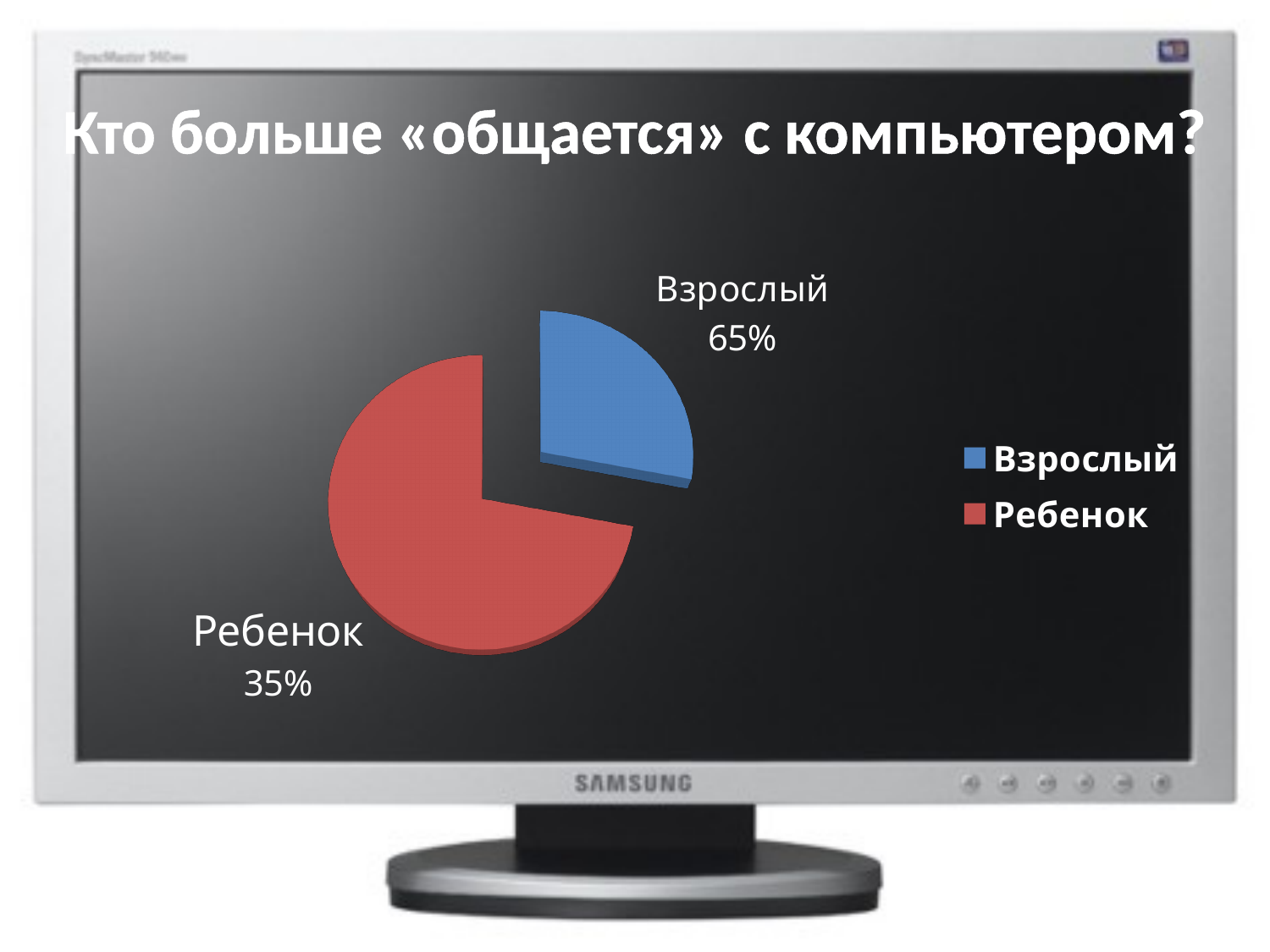
What percentage is shown for Ребенок in the pie chart? 35% How many entries does the legend list? 2 What percentage is shown for Взрослый in the pie chart? 65% What is the title of the slide containing the pie chart? Кто больше «общается» с компьютером? What is the difference in percentage points between the labels for Взрослый and Ребенок? 30 What is the sum of the two percentage labels shown on the pie chart? 100% How many slices does the pie chart have? 2 What type of chart is shown on the slide? Pie chart Which colour represents Ребенок in the legend? Red